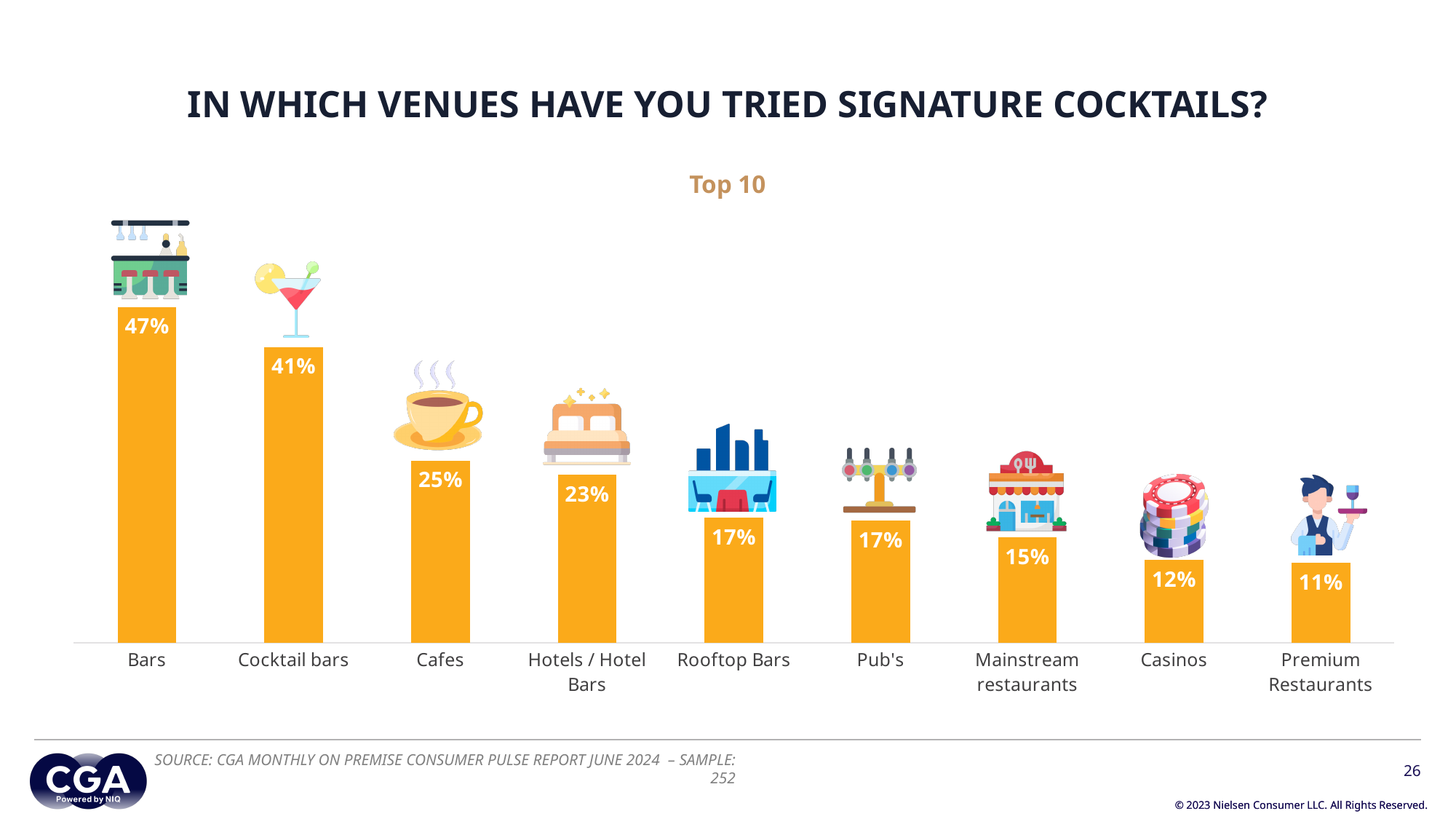
Which venue has the highest value in the chart? Bars What is the value shown for Cocktail bars? 41% What is the value shown for Casinos? 12% What is the difference between the values for Bars and Cocktail bars? 6% What is the subtitle shown above the chart? Top 10 Which venue has the lowest value in the chart? Premium Restaurants Which has a larger value, Cafes or Pub's? Cafes What percentage of respondents tried signature cocktails in Bars? 47% How many venue categories are shown in the chart? 9 What kind of chart is shown on the slide? Bar chart What is the value shown for Mainstream restaurants? 15% What is the difference between the values for Cafes and Hotels / Hotel Bars? 2%